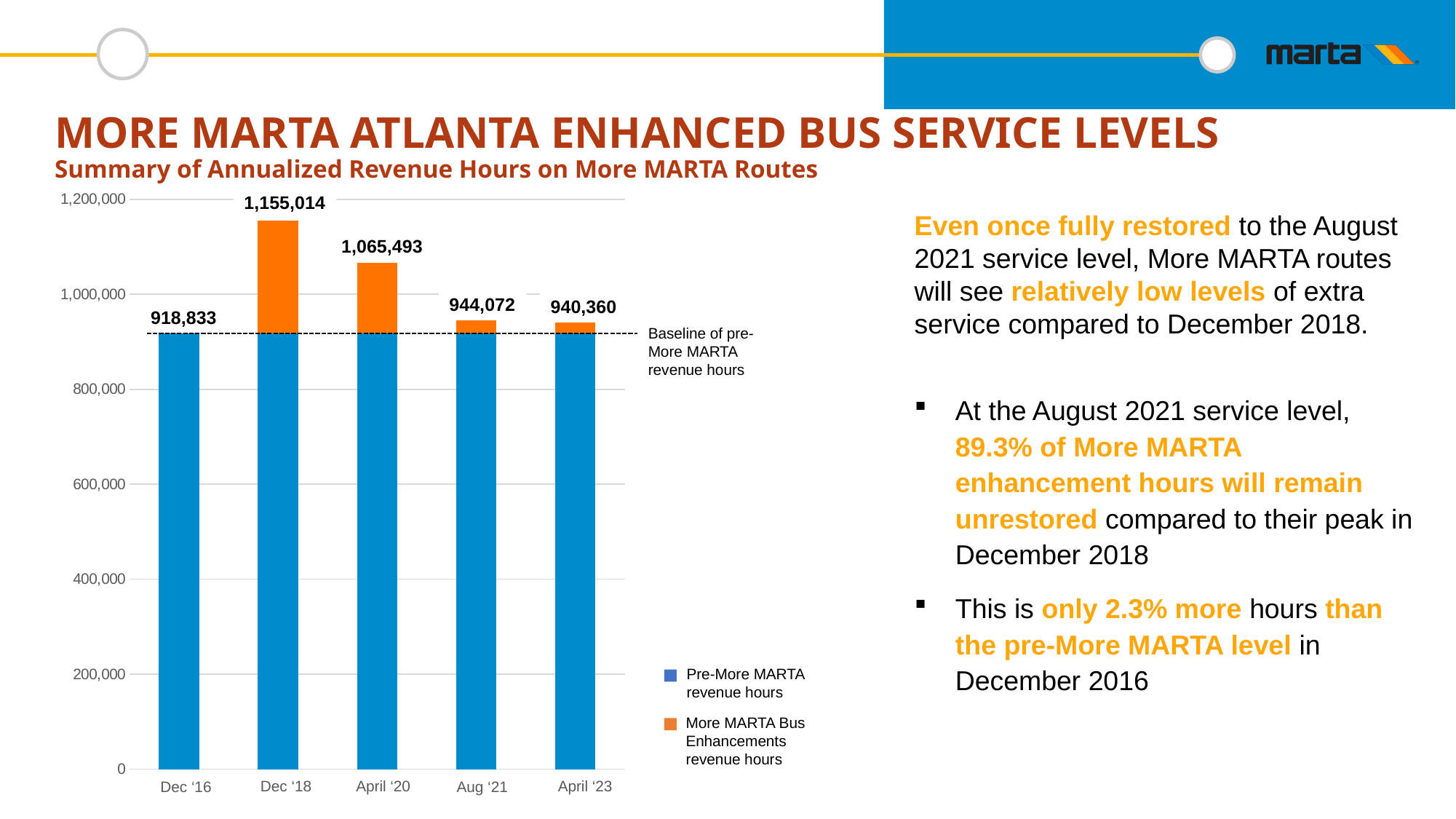
What type of chart is used to show the annualized revenue hours? Stacked bar chart What is the difference between the total revenue hours for Dec '18 and April '20? 89,521 How many series does the chart legend list? 2 Is the total revenue hours for Dec '18 greater or less than 1,000,000? greater What is the difference between the total revenue hours for Dec '18 and Dec '16? 236,181 What is the total annualized revenue hours shown for April '20? 1,065,493 How many periods are shown on the x axis of the chart? 5 What is the total annualized revenue hours shown for Dec '18? 1,155,014 Which period has the lowest total annualized revenue hours? Dec '16 What is the total annualized revenue hours shown for Dec '16? 918,833 Which period has the highest total annualized revenue hours? Dec '18 What is the total annualized revenue hours shown for April '23? 940,360